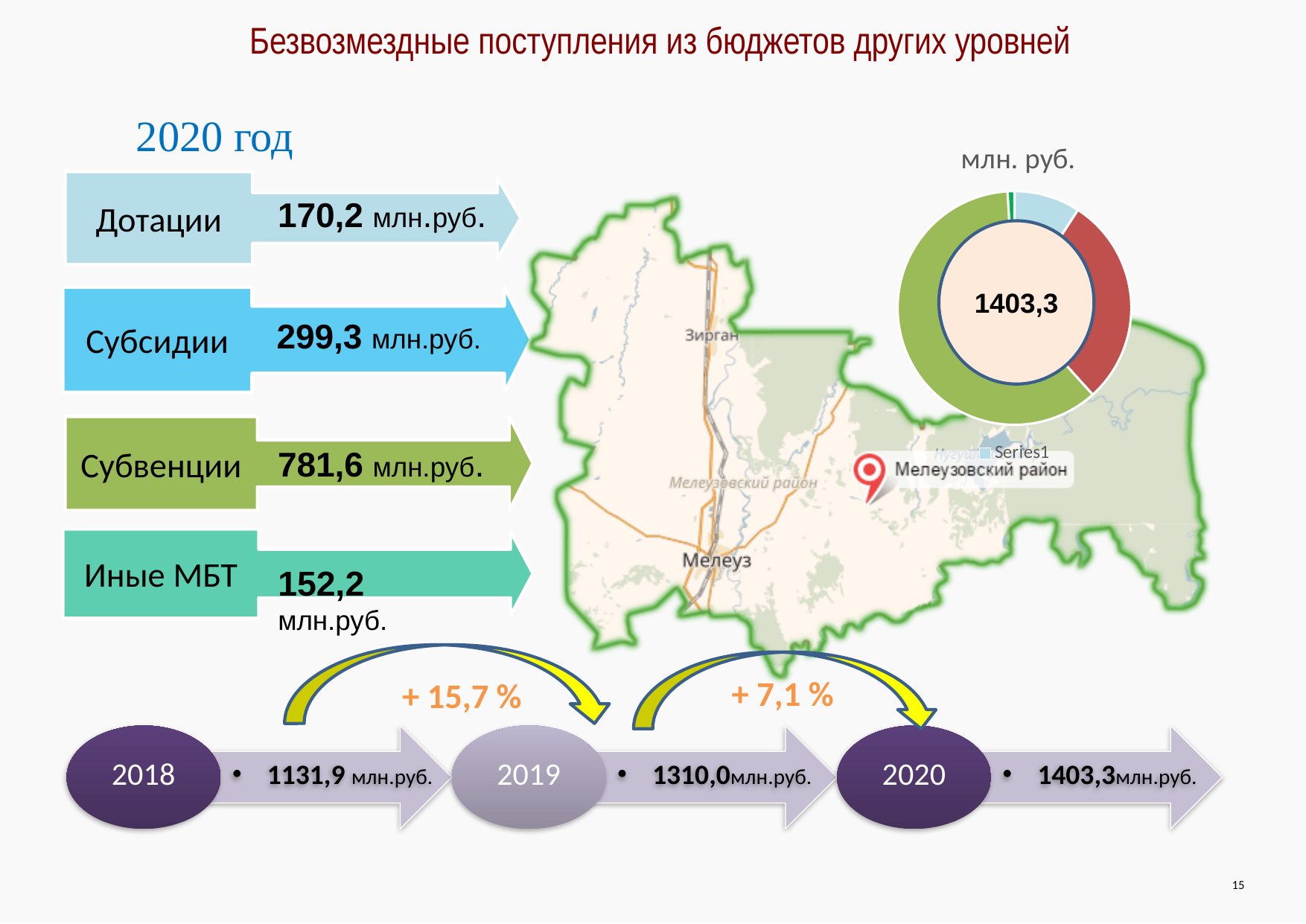
What is the legend entry shown for the doughnut chart? Series1 How many series does the legend of the doughnut chart list? 1 Which is larger in the doughnut chart, the red slice or the light blue slice? the red slice What unit label is shown above the doughnut chart? млн. руб. Which colour slice takes up the largest share of the doughnut chart? green Does the green slice of the doughnut chart cover more or less than half of the ring? more What kind of chart is shown on the right side of the slide, over the map? doughnut (pie) chart What value is printed in the centre of the doughnut chart? 1403,3